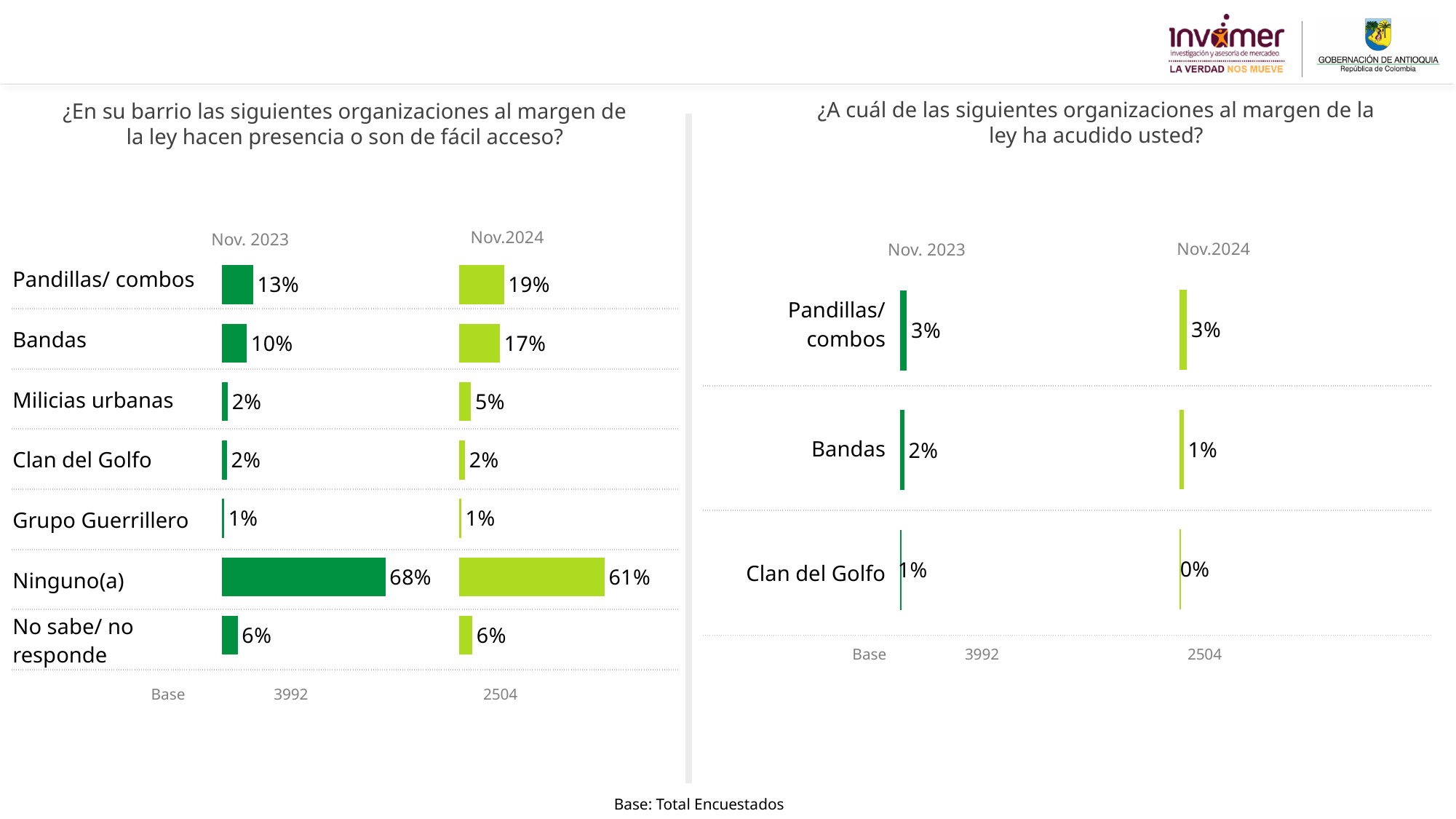
In the left chart, which category has the lowest Nov. 2023 value? Grupo Guerrillero In the left chart, what is the difference between the Nov. 2023 and Nov.2024 values for Ninguno(a)? 7% In the left chart, which category has the highest Nov.2024 value? Ninguno(a) In the right chart, how many categories are shown? 3 In the left chart, what is the base (number of respondents) for Nov.2024? 2504 In the left chart, what is the Nov.2024 value for Bandas? 17% In the left chart (¿En su barrio las siguientes organizaciones al margen de la ley hacen presencia o son de fácil acceso?), what is the Nov. 2023 value for Pandillas/ combos? 13% In the right chart, what is the Nov.2024 value for Clan del Golfo? 0% In the left chart, is the Nov.2024 value for Pandillas/ combos larger or smaller than its Nov. 2023 value? larger What kind of chart is the left chart? bar chart In the left chart, how many categories are shown? 7 In the right chart (¿A cuál de las siguientes organizaciones al margen de la ley ha acudido usted?), what is the Nov.2024 value for Bandas? 1%